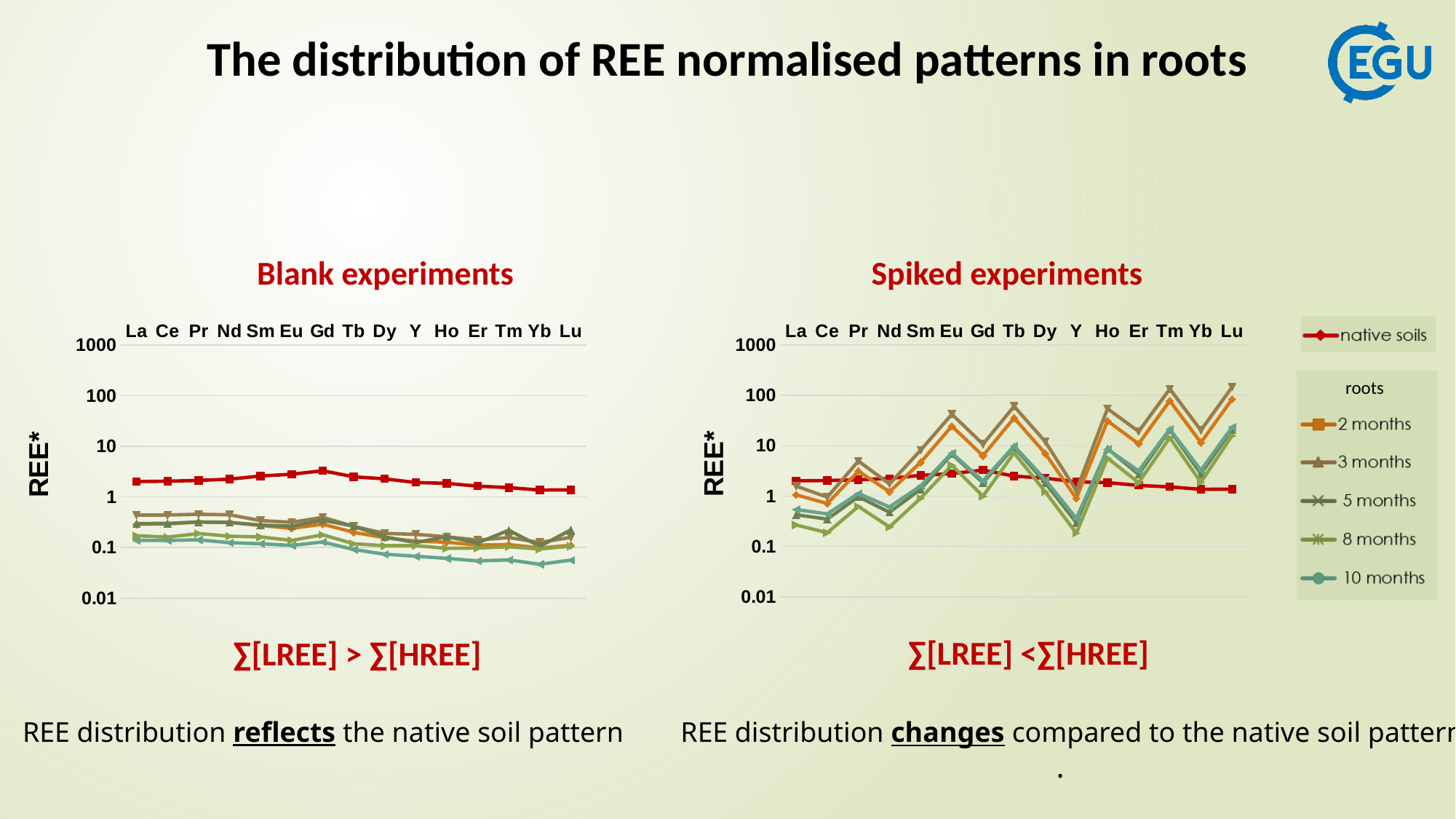
In the Blank experiments chart, is the native soils value at Gd greater or less than 1? greater What kind of chart is the Blank experiments chart? line chart In the Spiked experiments chart, at Lu, which is larger: the 3 months value or the 10 months value? 3 months What label is shown on the y axis of both charts? REE* In the Blank experiments chart, at which element does the native soils series reach its highest value? Gd In the Spiked experiments chart, at which element does the 3 months series reach its highest value? Lu In the Blank experiments chart, is the 10 months value at Lu greater or less than 0.1? less How many elements are listed along the x axis of the Spiked experiments chart? 15 In the Spiked experiments chart, is the 3 months value at Lu greater or less than 100? greater How many series does the legend list in total (native soils plus roots)? 6 In the Blank experiments chart, does the 10 months series generally rise or fall from La to Lu? fall